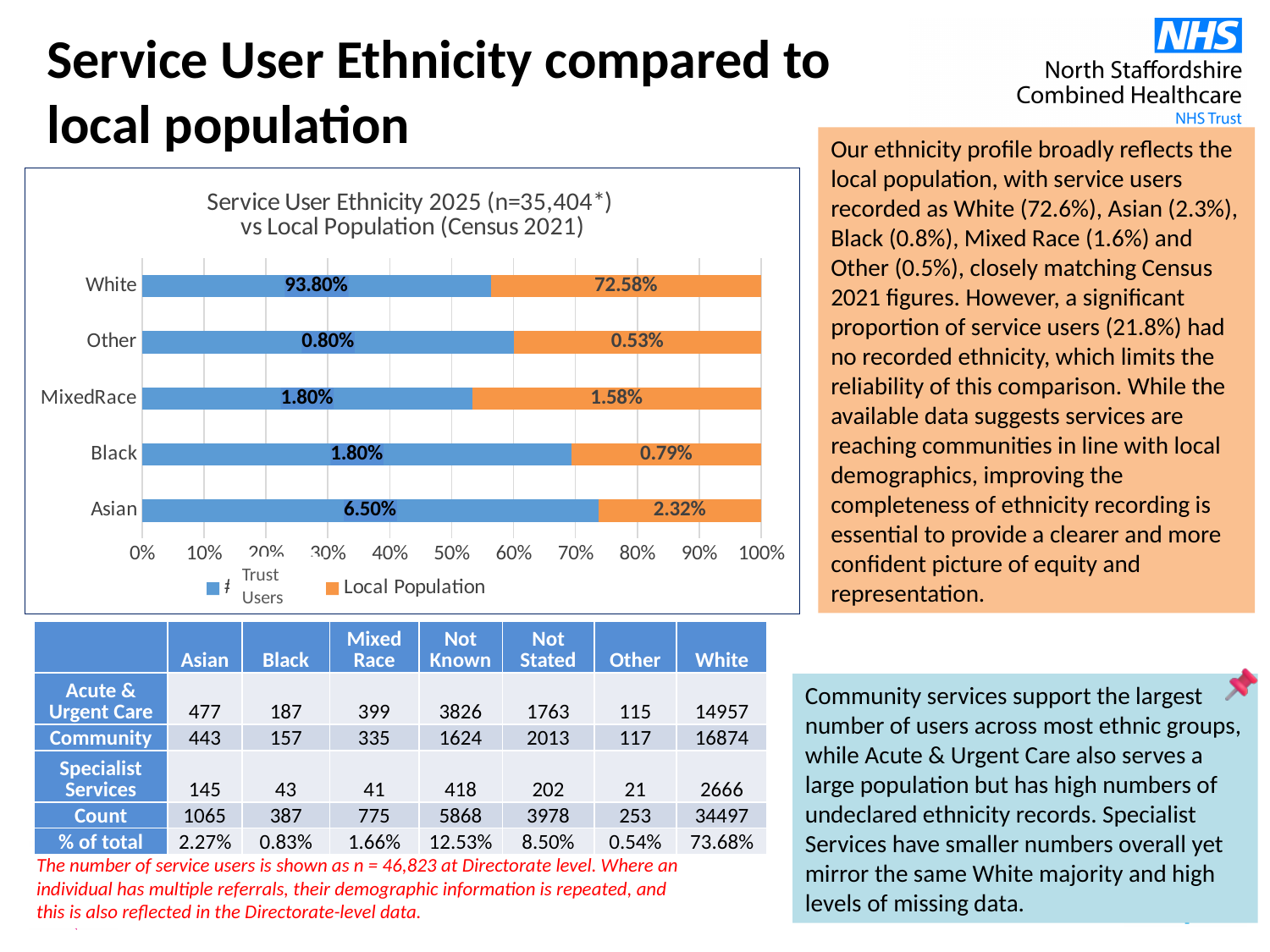
What is the Trust Users value for White? 93.80% How many series does the chart legend list? 2 Which ethnicity category has the highest Trust Users value? White Which ethnicity category has the lowest Local Population value? Other What kind of chart is shown on the slide? Bar chart What is the Local Population value for Black? 0.79% What is the Trust Users value for Other? 0.80% What is the difference between the Trust Users and Local Population values for Asian? 4.18 percentage points How many ethnicity categories are shown on the chart? 5 What is the difference between the Trust Users and Local Population values for White? 21.22 percentage points For Black, which is larger: the Trust Users value or the Local Population value? Trust Users What is the Local Population value for Asian? 2.32%